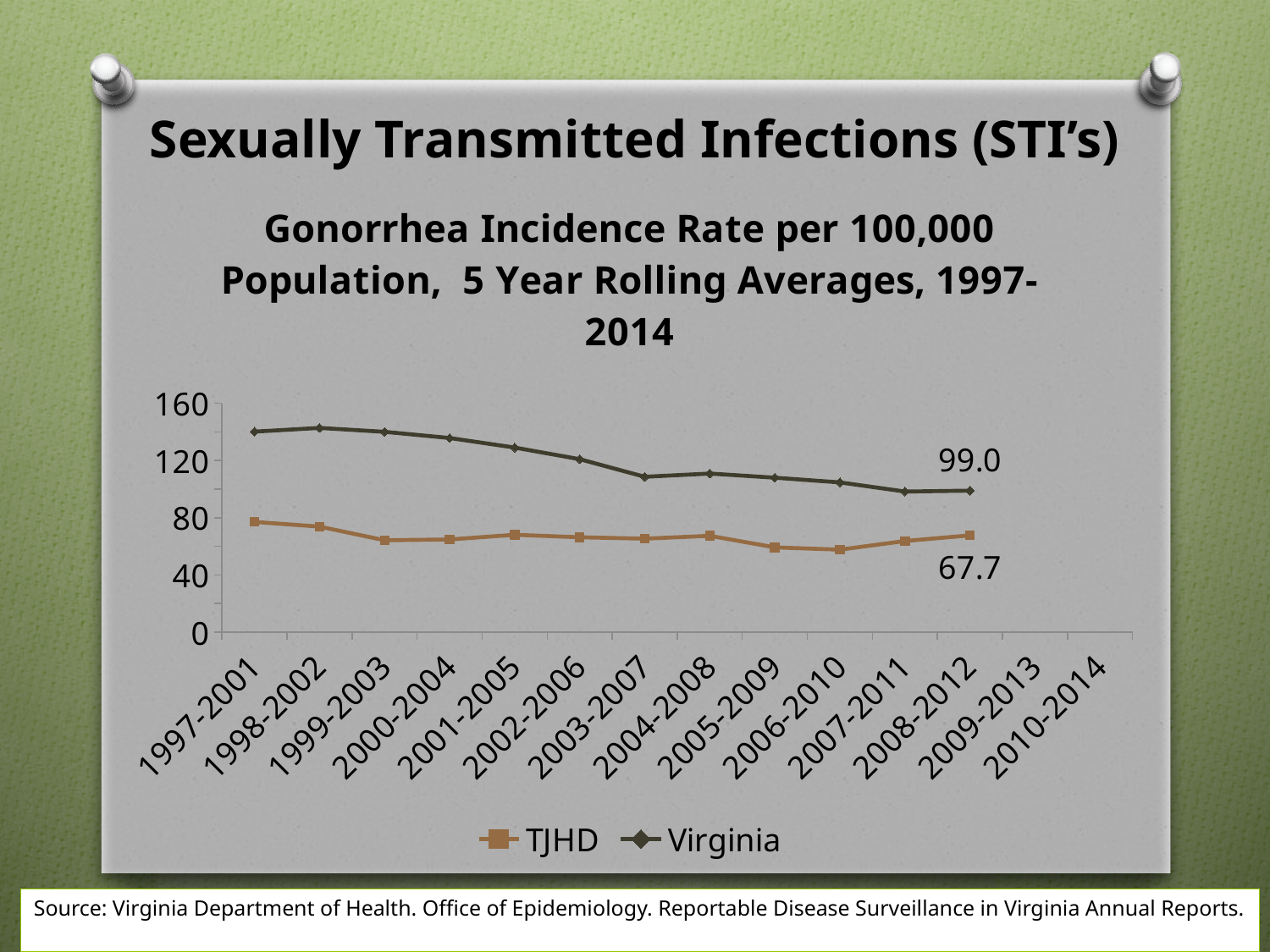
What is the labelled value for TJHD at the end of the series (2008-2012)? 67.7 Which series has the higher value for 2008-2012, TJHD or Virginia? Virginia What is the labelled value for Virginia at the end of the series (2008-2012)? 99.0 Does the Virginia line generally rise or fall from 1997-2001 to 2008-2012? fall How many series does the legend list? 2 Which two series are listed in the legend? TJHD and Virginia What kind of chart is shown on the slide? line chart Is the value for Virginia in 2003-2007 greater or less than 120? less What is the difference between the labelled Virginia value (99.0) and the labelled TJHD value (67.7)? 31.3 How many period labels are shown on the x axis? 14 Is the value for TJHD in 2006-2010 greater or less than 80? less Is the value for Virginia in 1997-2001 greater or less than 120? greater